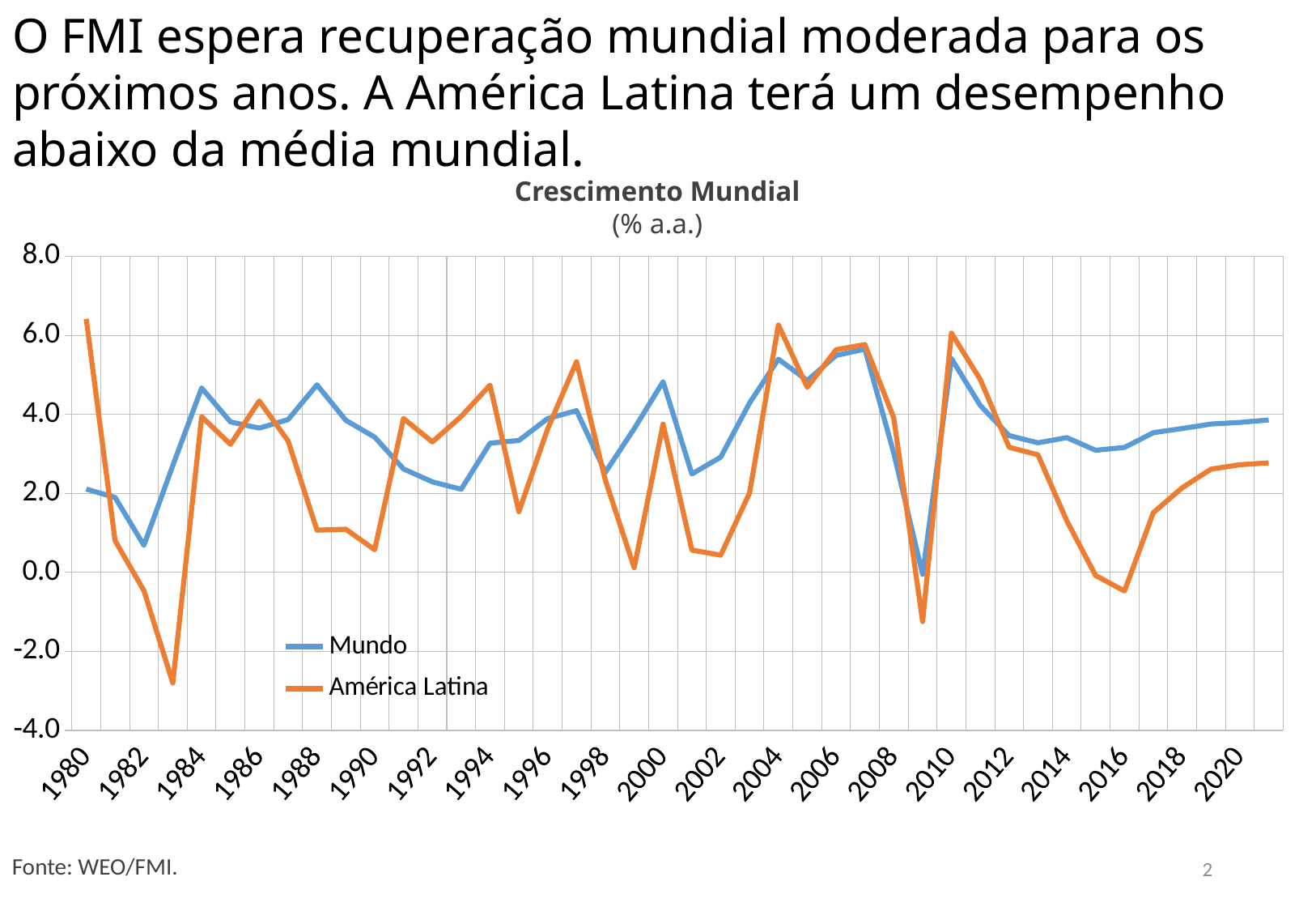
Is the value for América Latina in 2009 greater or less than 0.0? less How many series does the legend list? 2 In 2020, which series has the higher value, Mundo or América Latina? Mundo Is the value for América Latina in 1983 greater or less than -2.0? less In which year does the Mundo series reach its lowest value? 2009 Is the value for América Latina in 1980 greater or less than 6.0? greater Does the América Latina series rise or fall between 2010 and 2016? fall What kind of chart is shown on the slide? line chart What are the two series named in the legend? Mundo and América Latina What is the title of the chart? Crescimento Mundial (% a.a.) In which year does the América Latina series reach its lowest value? 1983